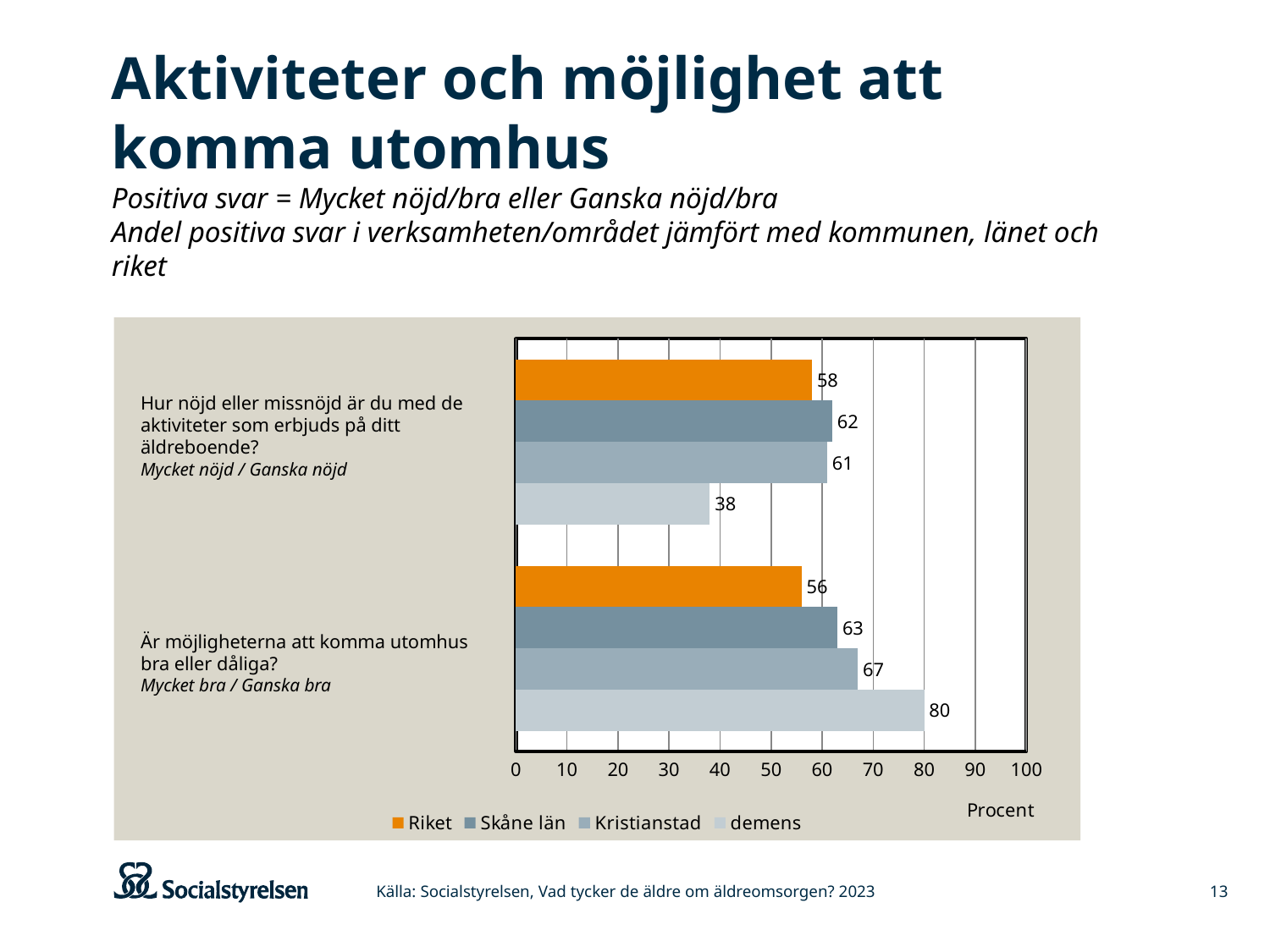
What is the value for Kristianstad on the question about whether the opportunities to get outdoors are good or bad? 67 What is the value for demens on the question about whether the opportunities to get outdoors are good or bad? 80 What is the value for demens on the question about satisfaction with activities offered at the care home? 38 What kind of chart is shown on the slide? bar chart Which is larger on the question about satisfaction with activities: the value for Skåne län or the value for demens? Skåne län What is the value for Riket on the question about satisfaction with activities offered at the care home? 58 What is the difference between the Skåne län value and the demens value on the question about satisfaction with activities offered? 24 Which series has the highest value on the question about opportunities to get outdoors? demens How many series does the legend list? 4 What unit label is shown below the x axis of the chart? Procent Which series has the lowest value on the question about satisfaction with activities offered? demens What is the difference between the demens value and the Riket value on the question about opportunities to get outdoors? 24